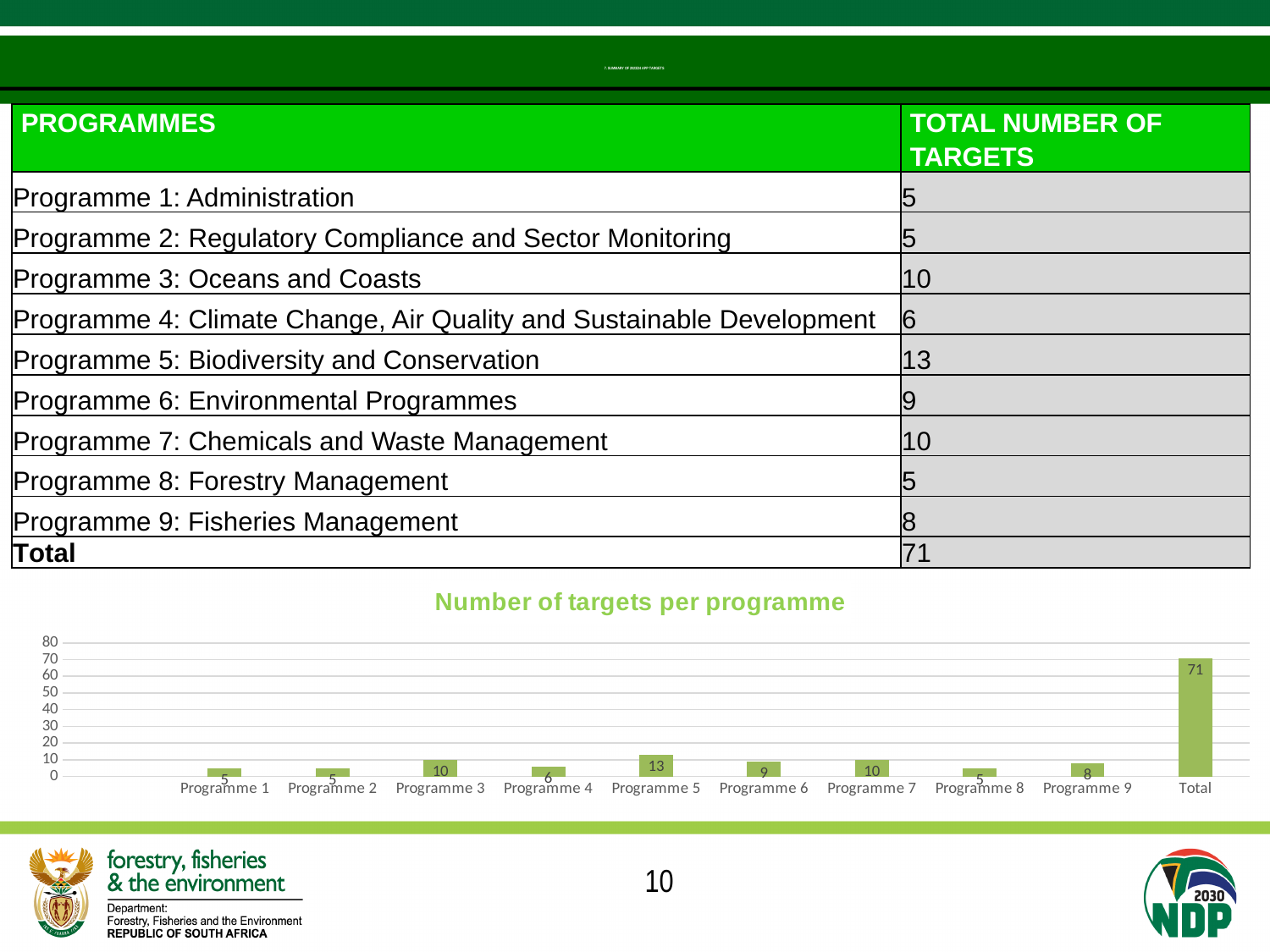
Which is larger, the value for Programme 6 or the value for Programme 9? Programme 6 What is the value for Programme 9 in the chart? 8 How many bars are plotted in the chart? 10 What is the value for the Total bar in the chart? 71 What is the title of the chart? Number of targets per programme Excluding the Total bar, which programme has the highest number of targets? Programme 5 What is the value for Programme 5 in the chart? 13 What type of chart is shown on the slide? bar chart What is the value for Programme 3 in the chart? 10 Is the value for the Total bar greater or less than 60? greater What is the difference between the values for Programme 5 and Programme 4? 7 What is the highest value shown on the vertical axis of the chart? 80